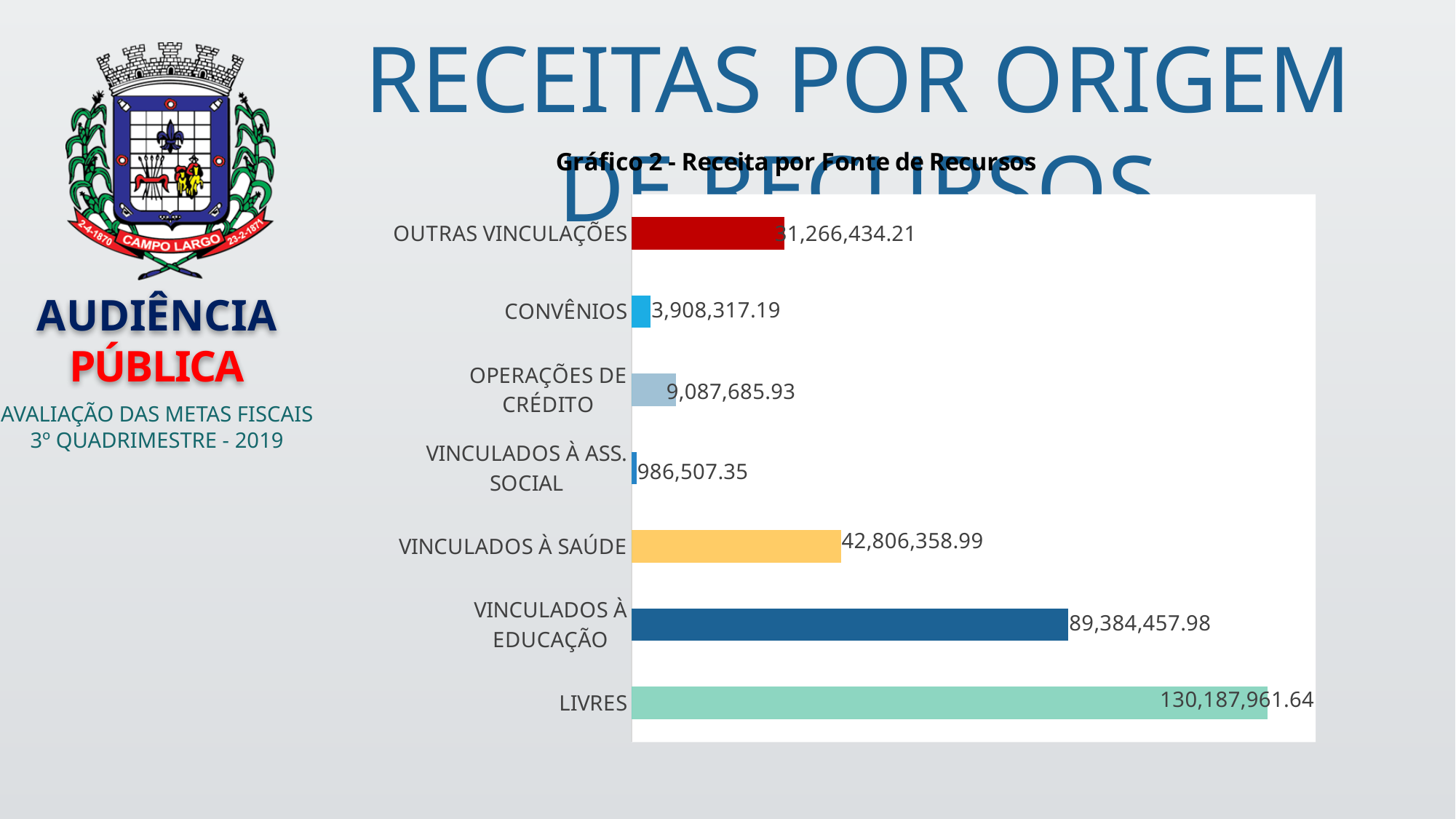
What kind of chart is shown? bar chart What is the difference between the values for LIVRES and VINCULADOS À EDUCAÇÃO? 40,803,503.66 What is the value for VINCULADOS À ASS. SOCIAL? 986,507.35 What is the value for VINCULADOS À SAÚDE? 42,806,358.99 Which category has the lowest value? VINCULADOS À ASS. SOCIAL What is the value for LIVRES? 130,187,961.64 How many categories are shown in the chart? 7 Which category has the highest value? LIVRES What is the value for CONVÊNIOS? 3,908,317.19 Which is larger, OPERAÇÕES DE CRÉDITO or CONVÊNIOS? OPERAÇÕES DE CRÉDITO What is the title of the chart? Gráfico 2 - Receita por Fonte de Recursos What is the difference between the values for VINCULADOS À SAÚDE and OUTRAS VINCULAÇÕES? 11,539,924.78